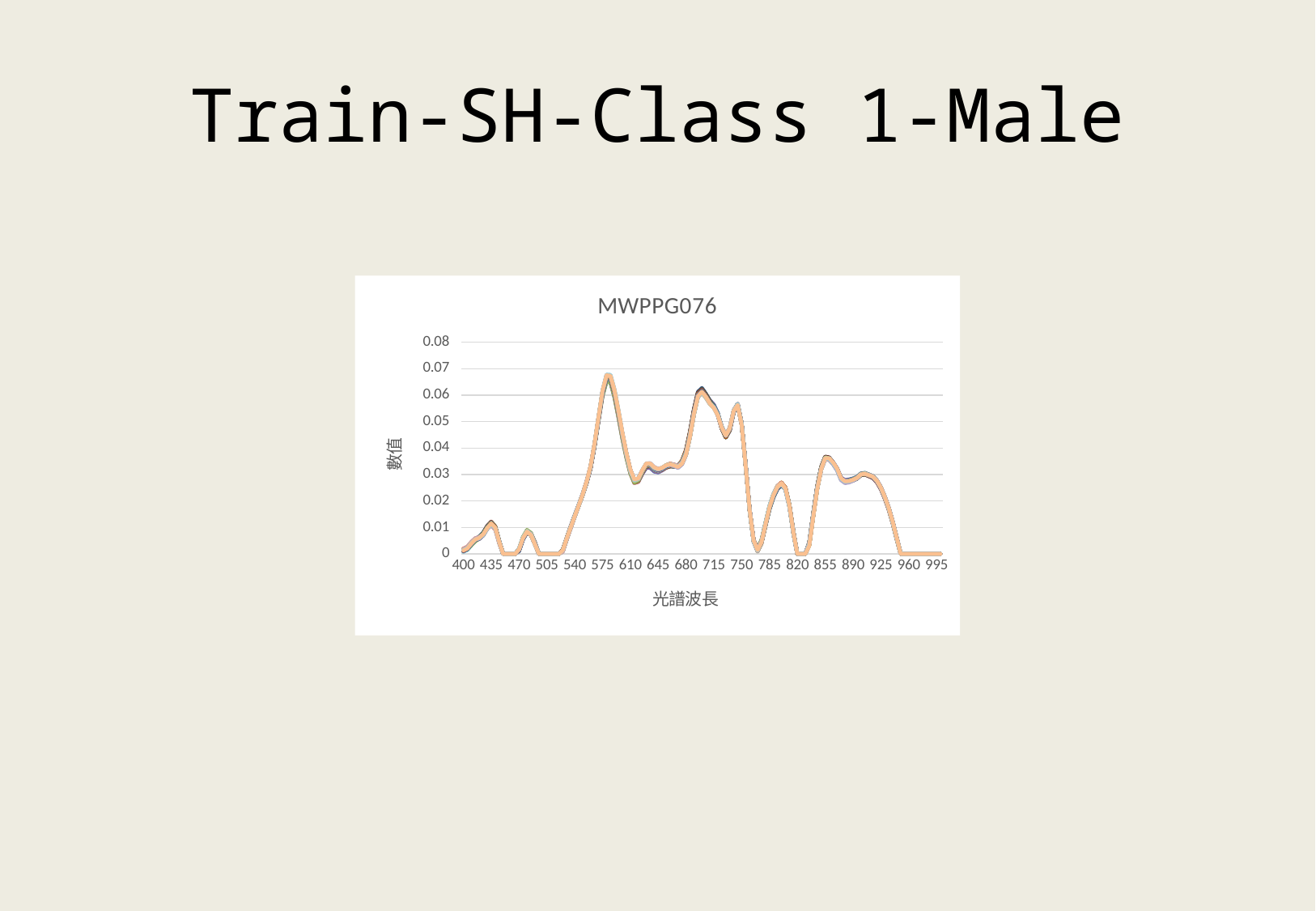
Is the value at 575 greater or less than 0.05? greater Is the value at 400 greater or less than 0.02? less Do the values rise or fall along the x axis from 540 to 575? rise What kind of chart is shown on the slide? line chart Between which two x-axis ticks does the highest peak of the chart occur? 575 and 610 Is the value at 995 greater or less than 0.01? less What is the label of the x axis of the chart? 光譜波長 Do the values rise or fall along the x axis from 925 to 960? fall What is the title of the chart? MWPPG076 How many tick labels are shown on the x axis of the chart? 18